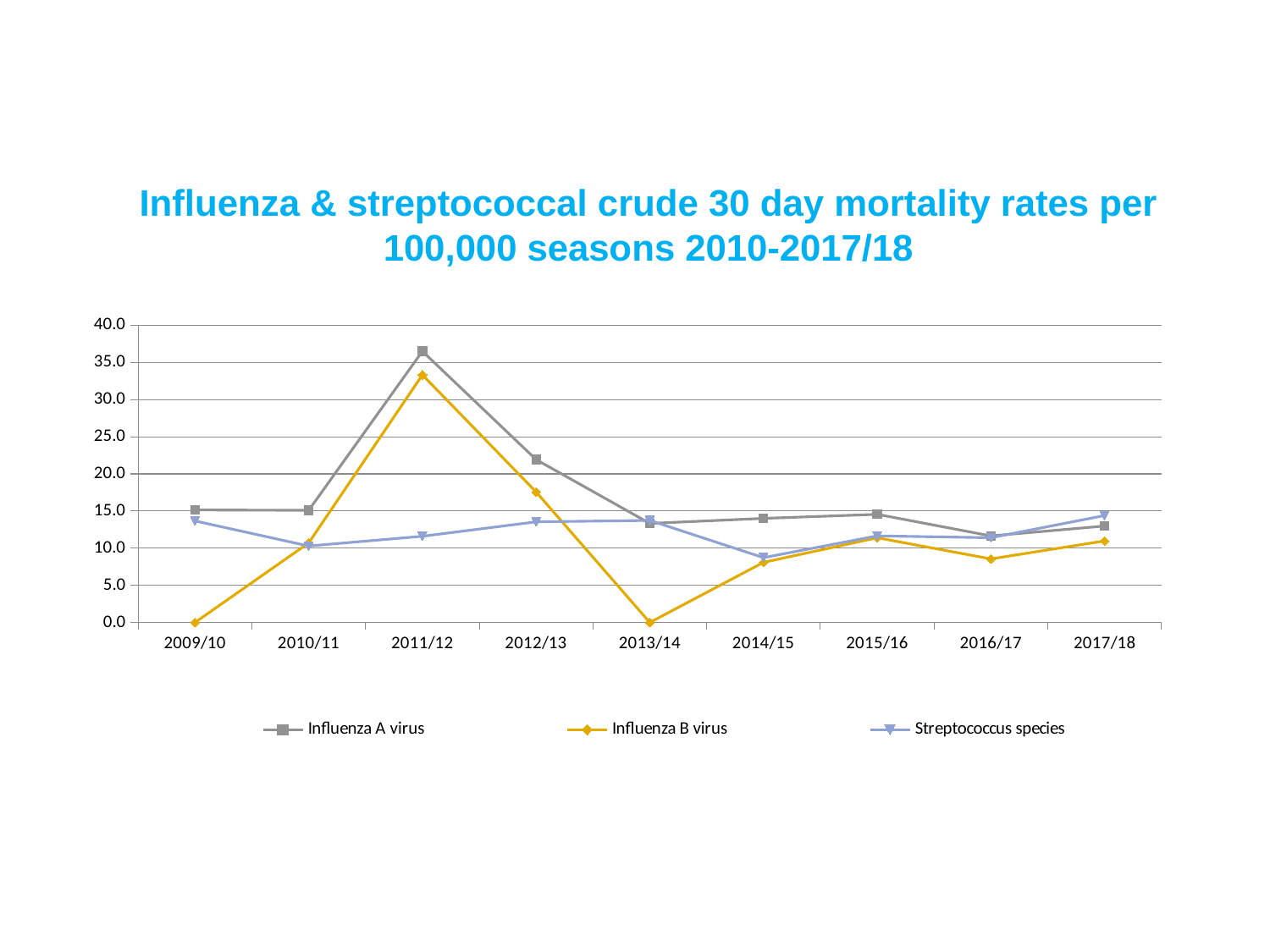
Is the value for Streptococcus species in 2014/15 greater or less than 10.0? less What kind of chart is shown on the slide? line chart In 2011/12, which is larger: Influenza A virus or Influenza B virus? Influenza A virus How many series does the legend list? 3 Is the value for Influenza A virus in 2011/12 greater or less than 35.0? greater Is the value for Influenza B virus in 2011/12 greater or less than 30.0? greater What is the value for Influenza B virus in 2009/10? 0.0 In which season is the Influenza A virus mortality rate highest? 2011/12 Does the Influenza A virus line rise or fall from 2011/12 to 2013/14? fall In which season is the Streptococcus species mortality rate lowest? 2014/15 How many seasons are shown on the x axis? 9 What is the value for Influenza B virus in 2013/14? 0.0